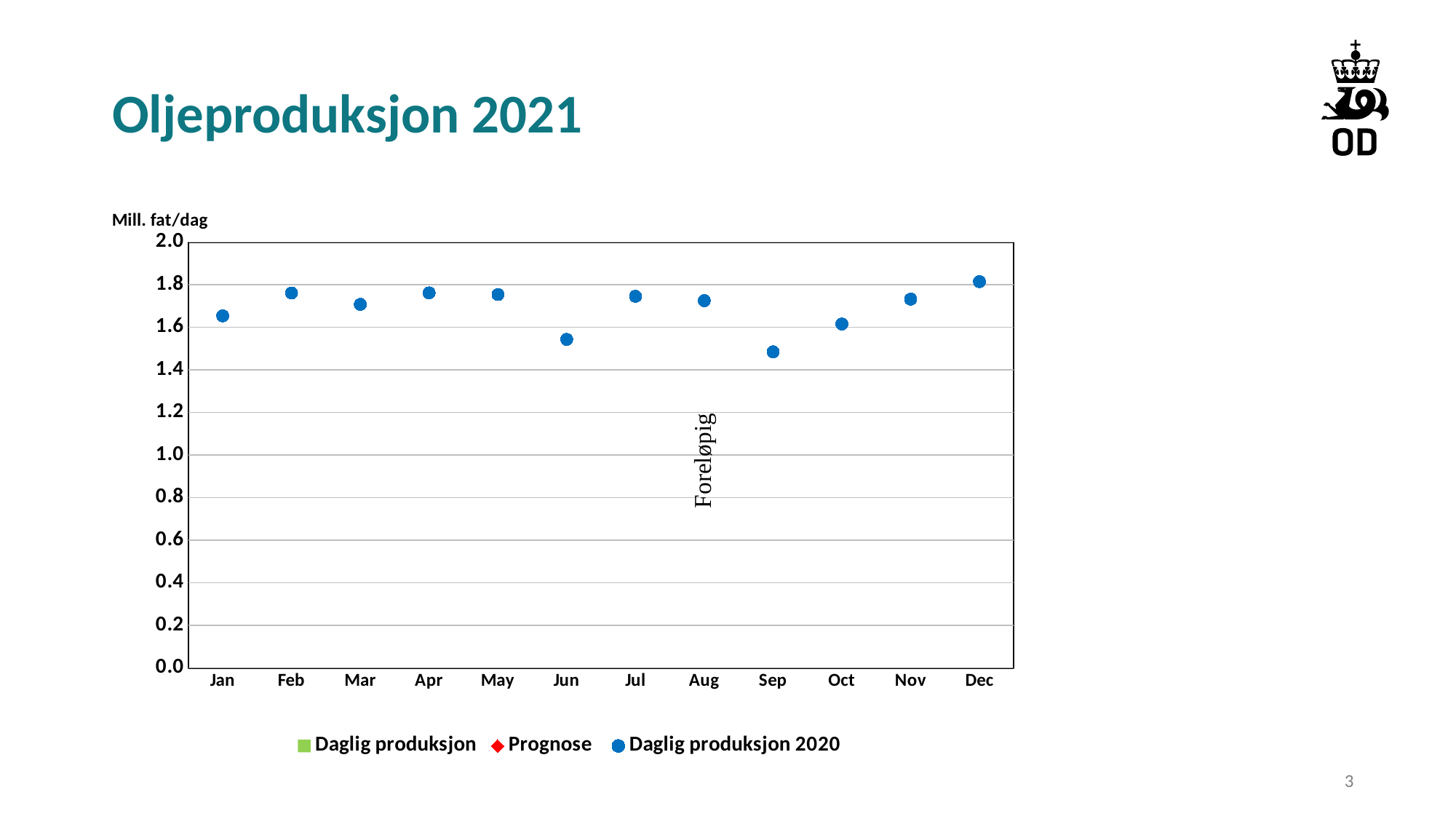
What unit is shown above the y axis of the chart? Mill. fat/dag Is the Daglig produksjon 2020 value for Feb greater or less than 1.6? greater Is the Daglig produksjon 2020 value for Jan greater or less than 1.6? greater Which month has the larger Daglig produksjon 2020 value, Jun or Sep? Jun How many months are shown on the x axis of the chart? 12 Which month has the larger Daglig produksjon 2020 value, Jan or Feb? Feb In which month is the plotted value for Daglig produksjon 2020 lowest? Sep Is the Daglig produksjon 2020 value for Sep greater or less than 1.6? less What is the title of the chart on the slide? Oljeproduksjon 2021 In which month is the plotted value for Daglig produksjon 2020 highest? Dec How many series does the chart legend list? 3